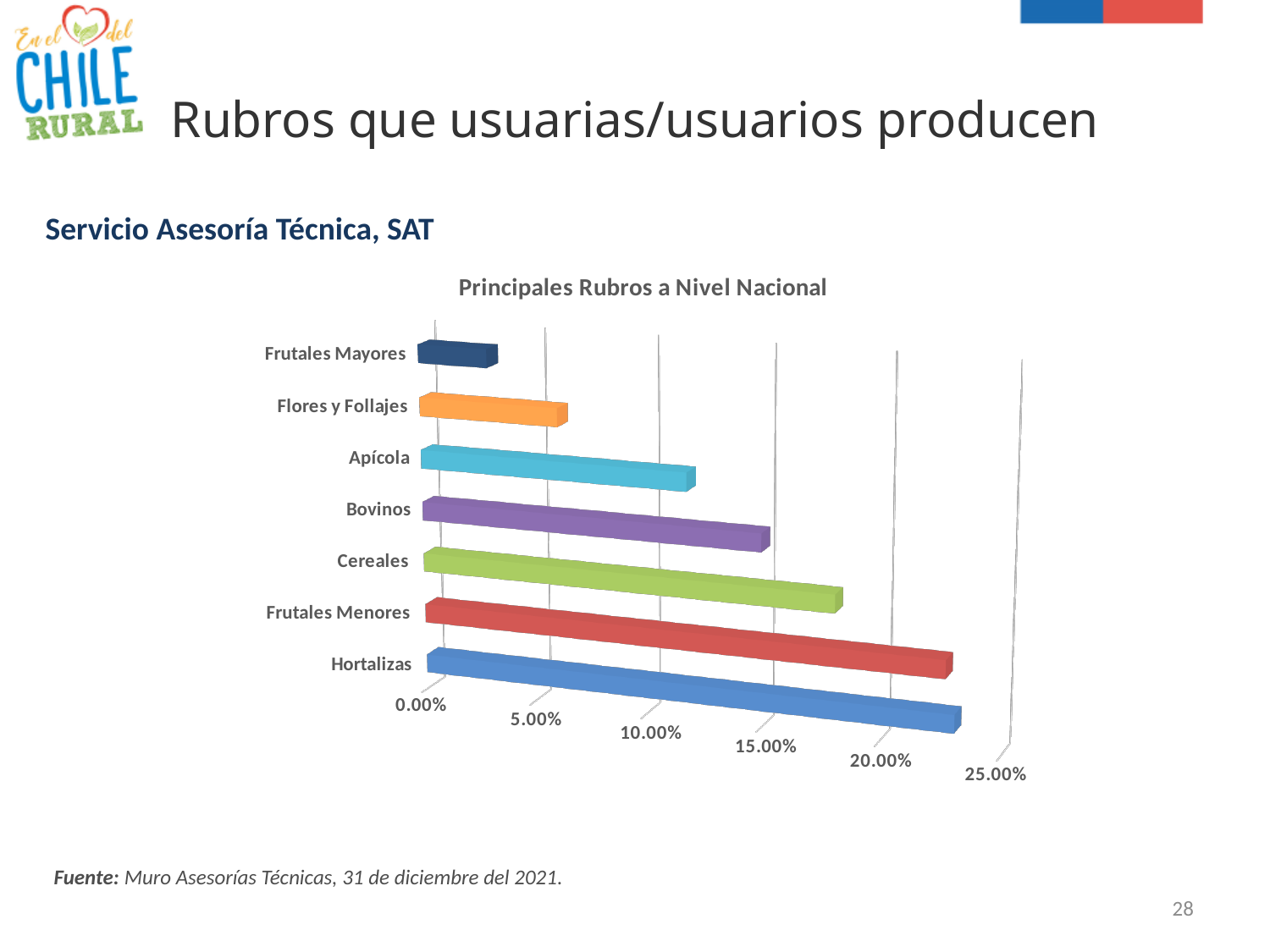
How many categories (rubros) are plotted in the chart? 7 Which category has the lowest value in the chart? Frutales Mayores Is the value for Cereales greater or less than 15.00%? greater Is the value for Frutales Menores greater or less than 20.00%? greater Is the value for Cereales greater or less than 20.00%? less What kind of chart is shown on the slide? bar chart What is the title of the chart? Principales Rubros a Nivel Nacional Which has a larger value, Cereales or Bovinos? Cereales Which has a larger value, Apícola or Flores y Follajes? Apícola